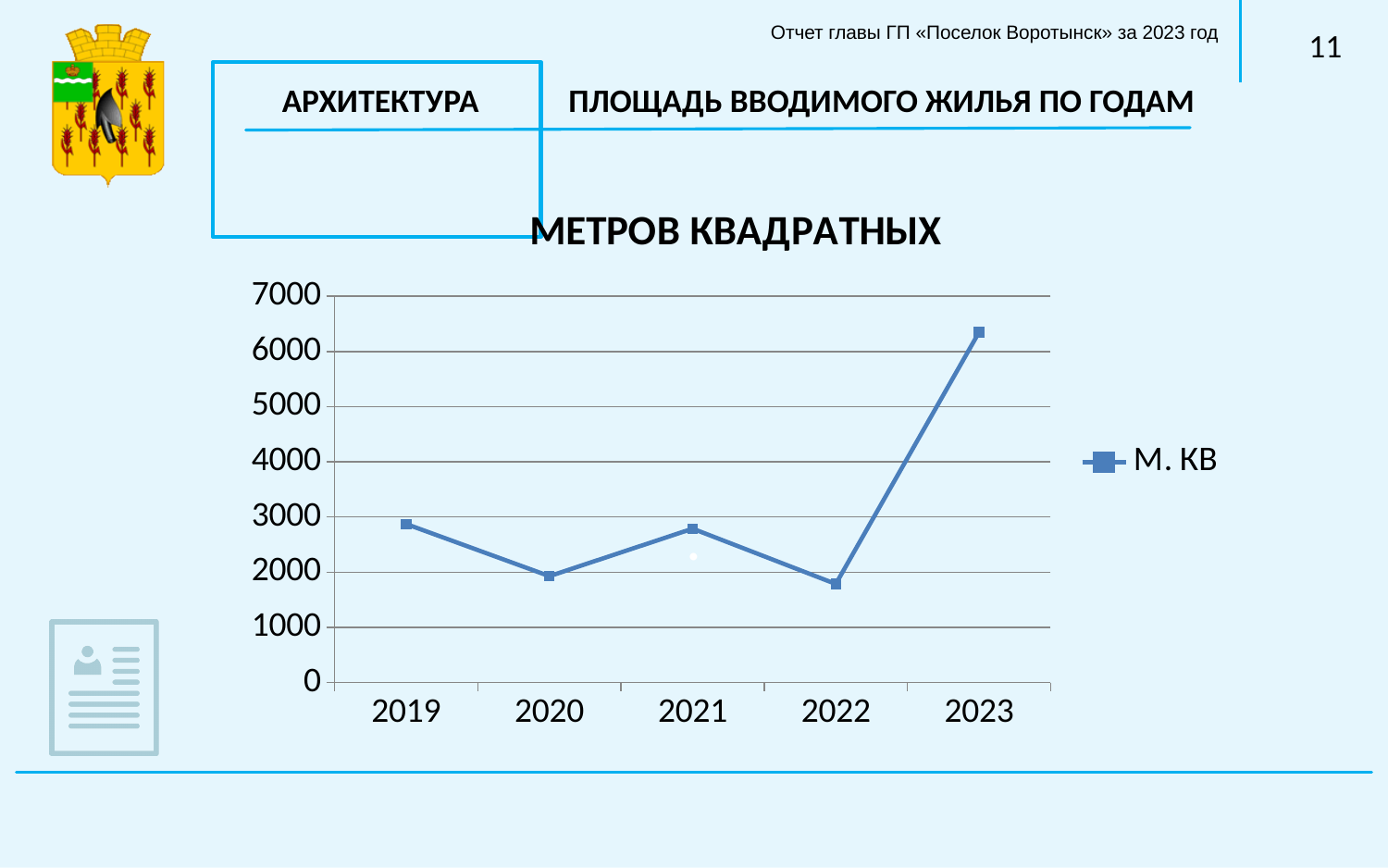
How many years are plotted on the x axis? 5 What kind of chart is shown on the slide? line chart Which year has the highest value in the chart? 2023 Is the value for 2021 greater or less than 2000? greater Is the value for 2023 greater or less than 6000? greater Is the value for 2022 greater or less than 2000? less Which is larger, the value for 2019 or the value for 2020? 2019 What is the legend entry for the plotted series? М. КВ What is the title of the chart? МЕТРОВ КВАДРАТНЫХ How many series does the legend list? 1 Does the value rise or fall from 2022 to 2023? rise